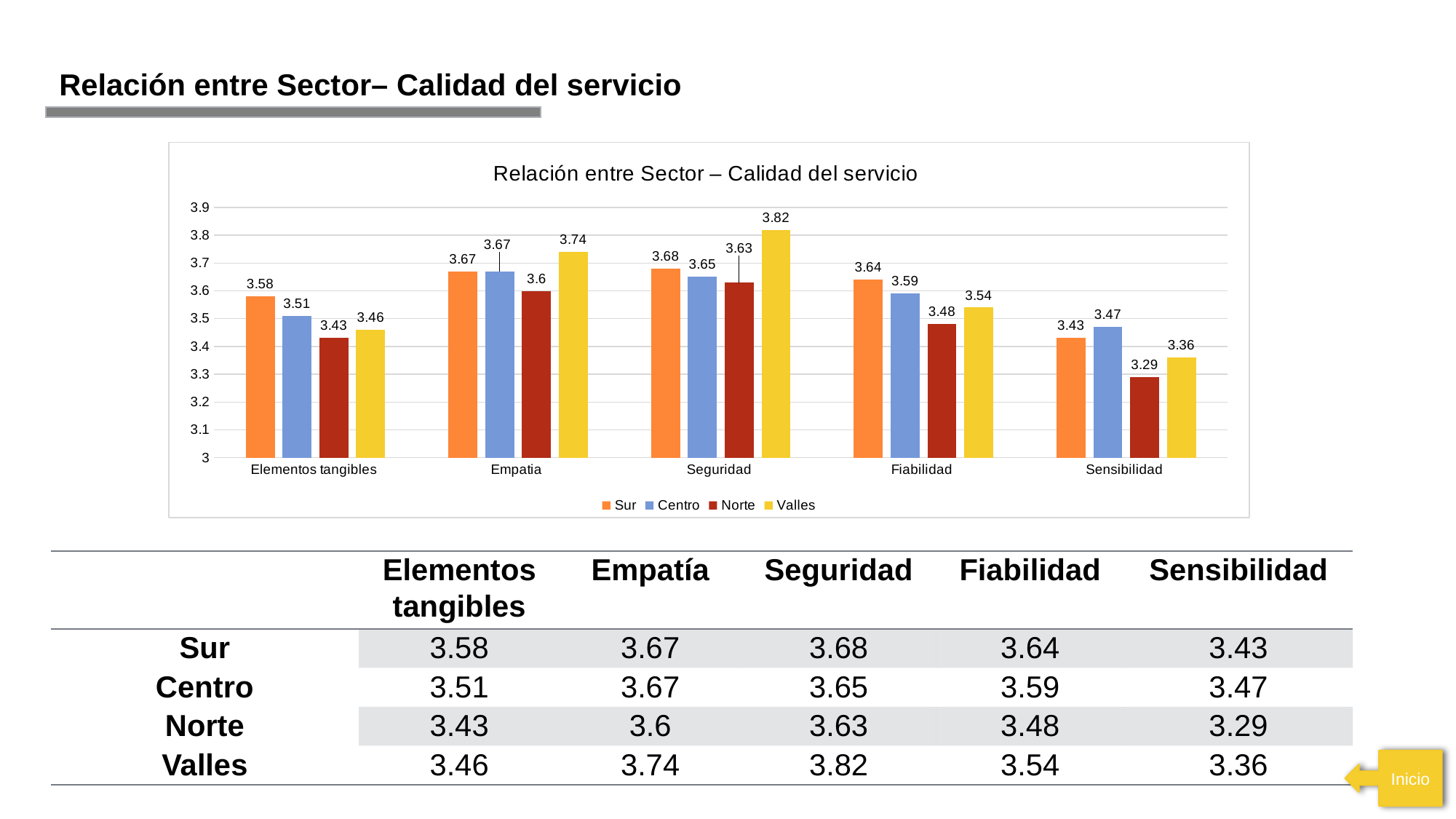
What is the title of the chart? Relación entre Sector – Calidad del servicio How many series does the legend list? 4 How many categories are shown on the x axis? 5 Which series has the lowest value in the Fiabilidad category? Norte Which series is shown in yellow in the legend? Valles What is the difference between the Valles and Norte values in the Seguridad category? 0.19 What is the value for Sur in the Seguridad category? 3.68 Which series has the highest value in the Seguridad category? Valles What kind of chart is shown? Bar chart What is the value for Valles in the Empatia category? 3.74 Which is larger: the Sur value for Elementos tangibles or the Centro value for Elementos tangibles? Sur What is the value for Norte in the Sensibilidad category? 3.29